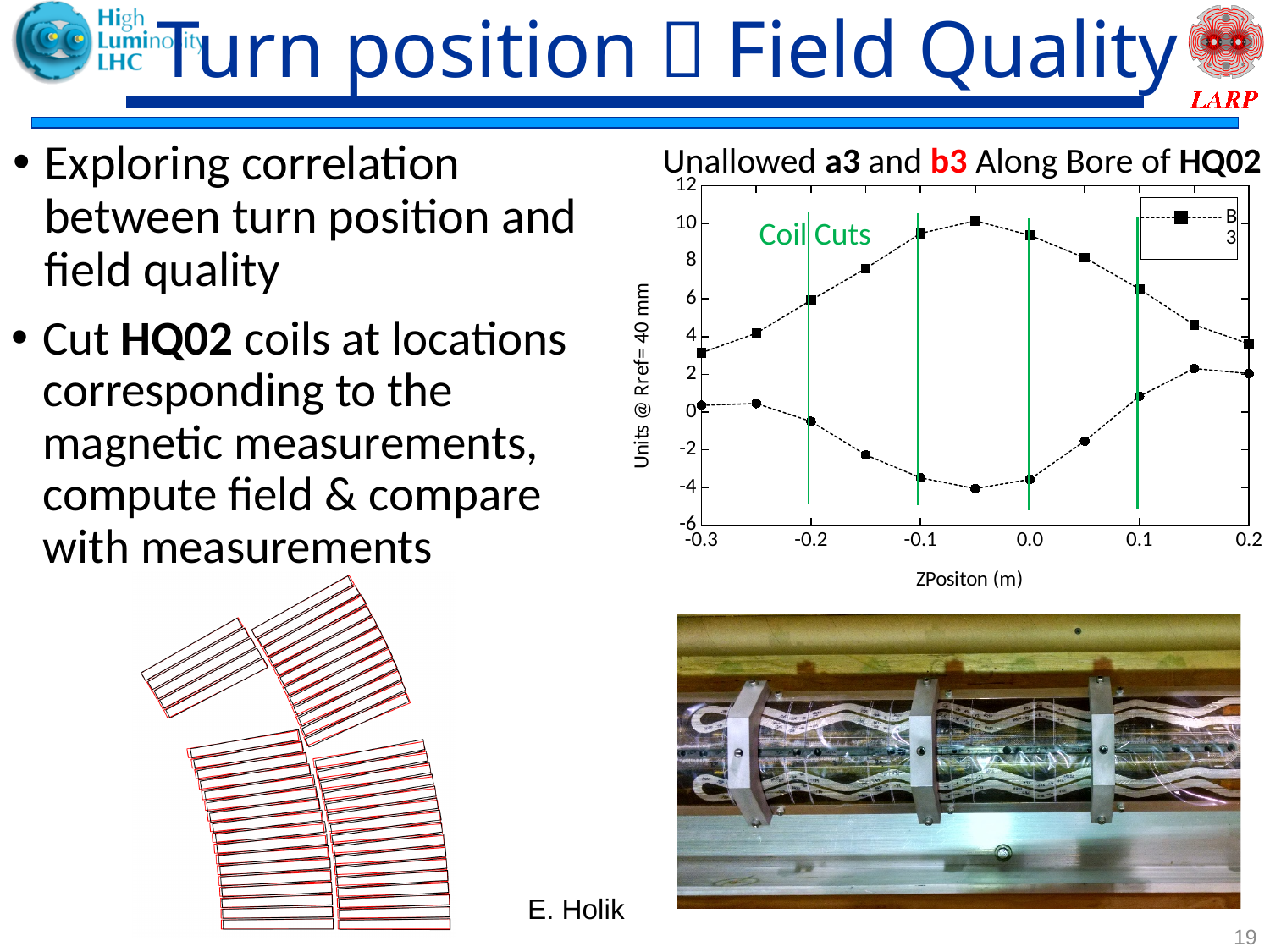
Is the value of the square-marker (B3) series at ZPosition -0.3 greater or less than 4? less How many green vertical 'Coil Cuts' lines are drawn on the chart? 4 At ZPosition 0.0, which series has the larger value, the square-marker (B3) series or the circle-marker series? Square-marker (B3) series Between ZPosition -0.3 and -0.05, does the square-marker (B3) series rise or fall? Rise At which ZPosition does the square-marker (B3) series reach its highest value? -0.05 What is the label of the x axis of the chart? ZPositon (m) Is the value of the circle-marker series at ZPosition 0.2 greater or less than 0? greater What kind of chart is shown on the slide? Line chart What is the title of the chart? Unallowed a3 and b3 Along Bore of HQ02 How many data points does the square-marker (B3) series have? 11 Is the value of the square-marker (B3) series at ZPosition -0.05 greater or less than 8? greater